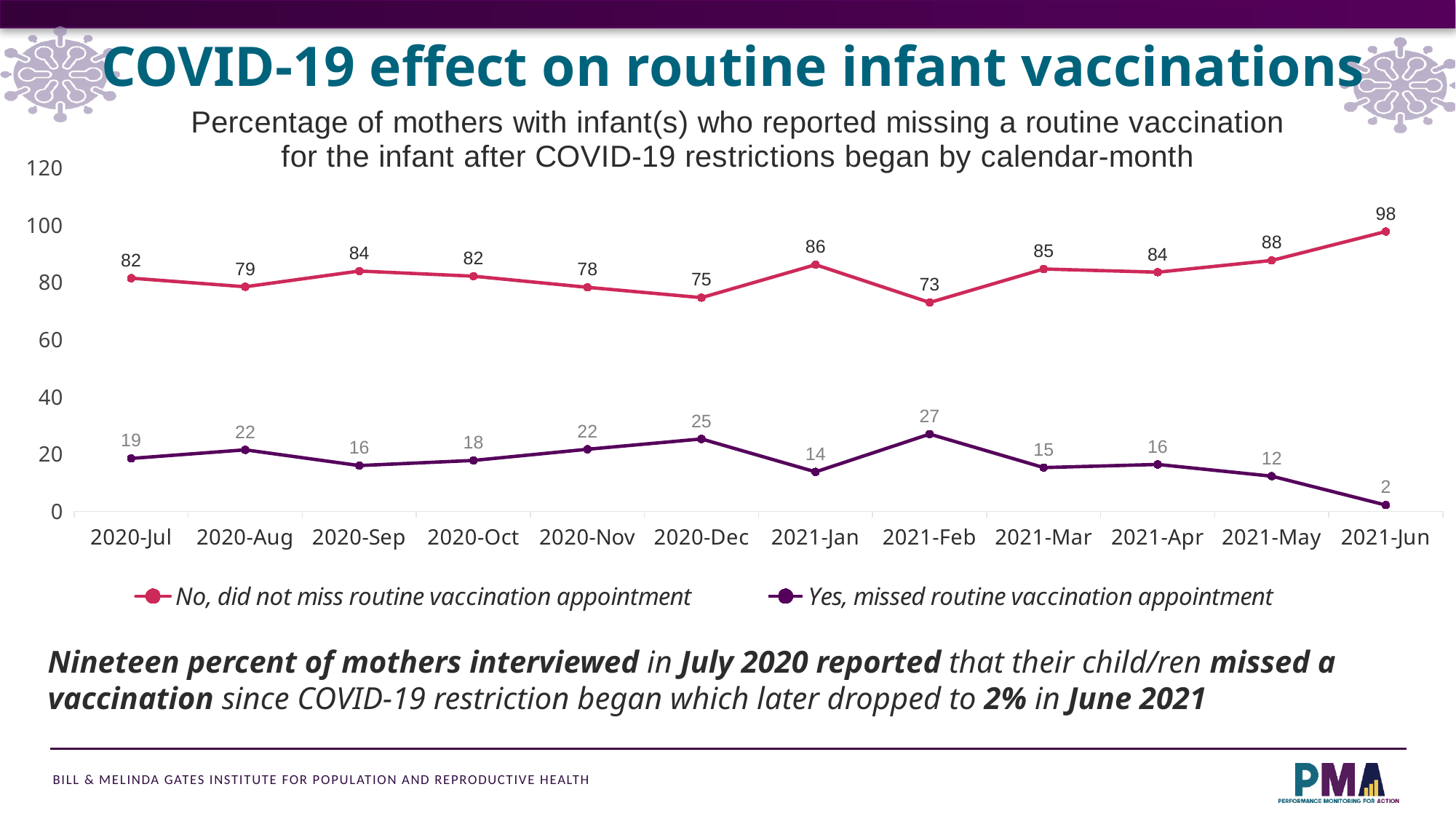
In which month is the 'Yes, missed routine vaccination appointment' series highest? 2021-Feb Which is larger: the 'Yes, missed' value in 2020-Dec or in 2021-Jan? 2020-Dec What is the value for 'Yes, missed routine vaccination appointment' in 2020-Jul? 19 What is the difference between the 'No, did not miss' value in 2021-Jun and in 2020-Jul? 16 What is the value for 'No, did not miss routine vaccination appointment' in 2021-Jun? 98 How many series does the legend list? 2 How many months are shown on the x axis? 12 In which month is the 'Yes, missed routine vaccination appointment' series lowest? 2021-Jun In which month is the 'No, did not miss routine vaccination appointment' series lowest? 2021-Feb Is the 'No, did not miss routine vaccination appointment' value in 2021-Jun greater or less than 80? greater What kind of chart is shown on the slide? Line chart What is the value for 'Yes, missed routine vaccination appointment' in 2021-Feb? 27